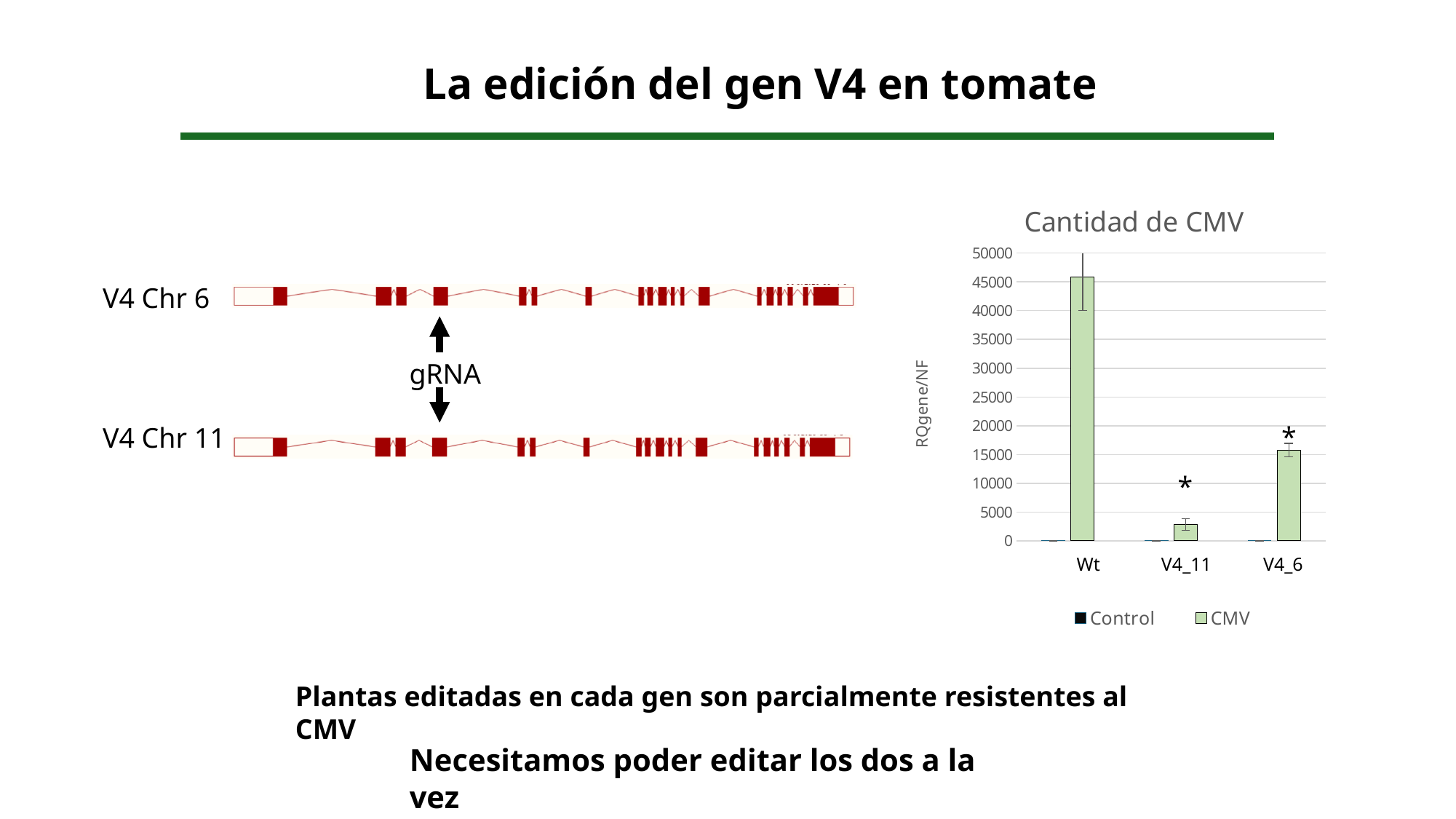
Which category has the lowest CMV value in the chart? V4_11 How many categories are shown on the x axis of the chart? 3 Is the CMV value for Wt greater or less than 40000? greater Is the CMV value for V4_6 greater or less than 10000? greater Which has a larger CMV value, V4_6 or V4_11? V4_6 Is the CMV value for V4_11 greater or less than 5000? less What is the label of the y axis of the chart? RQgene/NF Which category has the highest CMV value in the chart? Wt What kind of chart is shown on the slide? bar chart Which series is shown in green in the chart? CMV What is the title of the chart? Cantidad de CMV How many series does the chart's legend list? 2